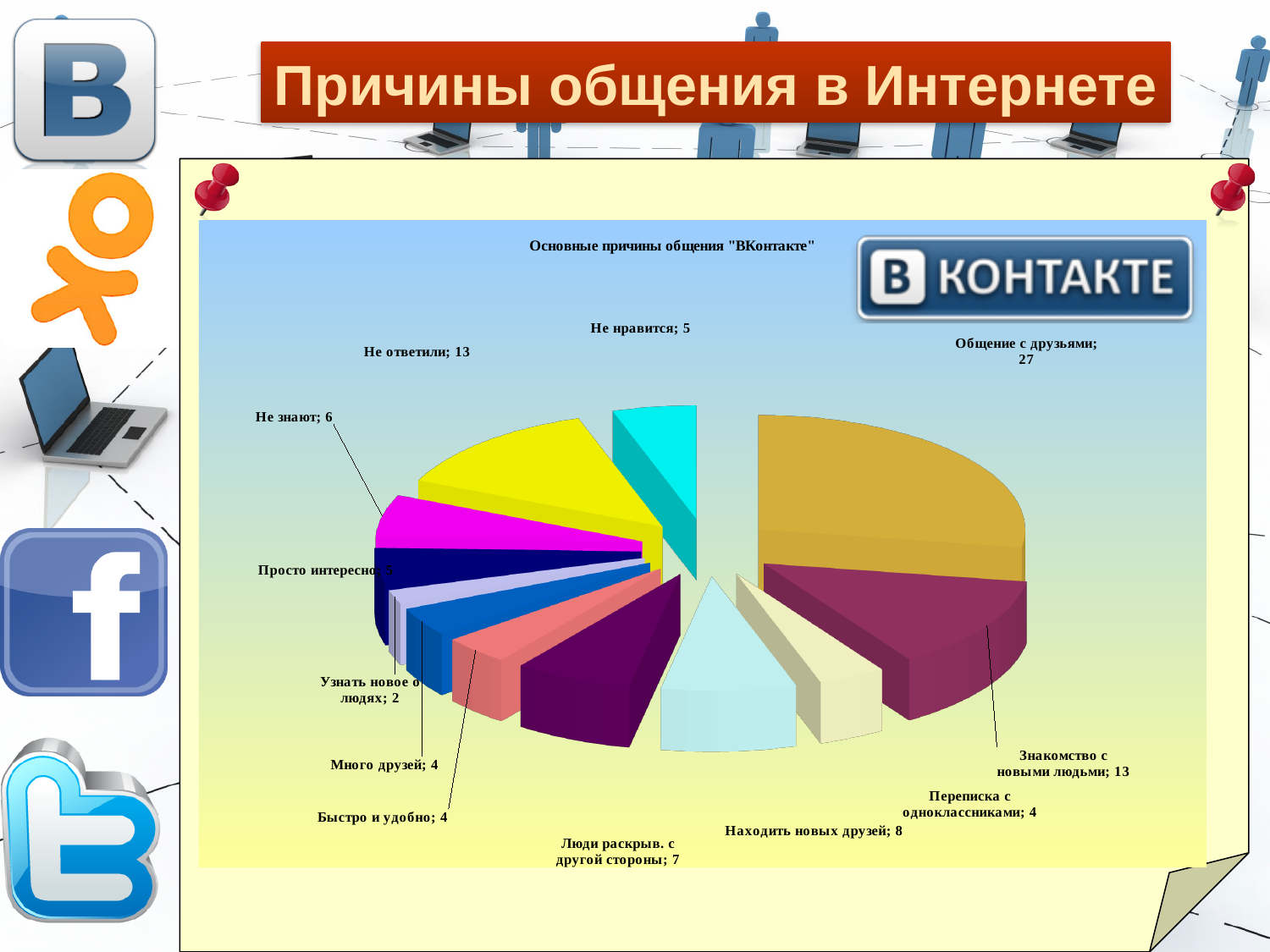
What is the value for "Знакомство с новыми людьми"? 13 Which category has the largest value in the pie chart? Общение с друзьями How many categories (slices) does the pie chart have? 12 What is the difference between the values for "Общение с друзьями" and "Знакомство с новыми людьми"? 14 Which category has the smallest value in the pie chart? Узнать новое о людях Which is larger: the value for "Не знают" or the value for "Просто интересно"? Не знают What is the value for "Находить новых друзей"? 8 What is the title of the chart? Основные причины общения "ВКонтакте" What type of chart is shown on the slide? Pie chart What is the difference between the values for "Не ответили" and "Находить новых друзей"? 5 What is the value for "Общение с друзьями"? 27 What is the value for "Люди раскрыв. с другой стороны"? 7